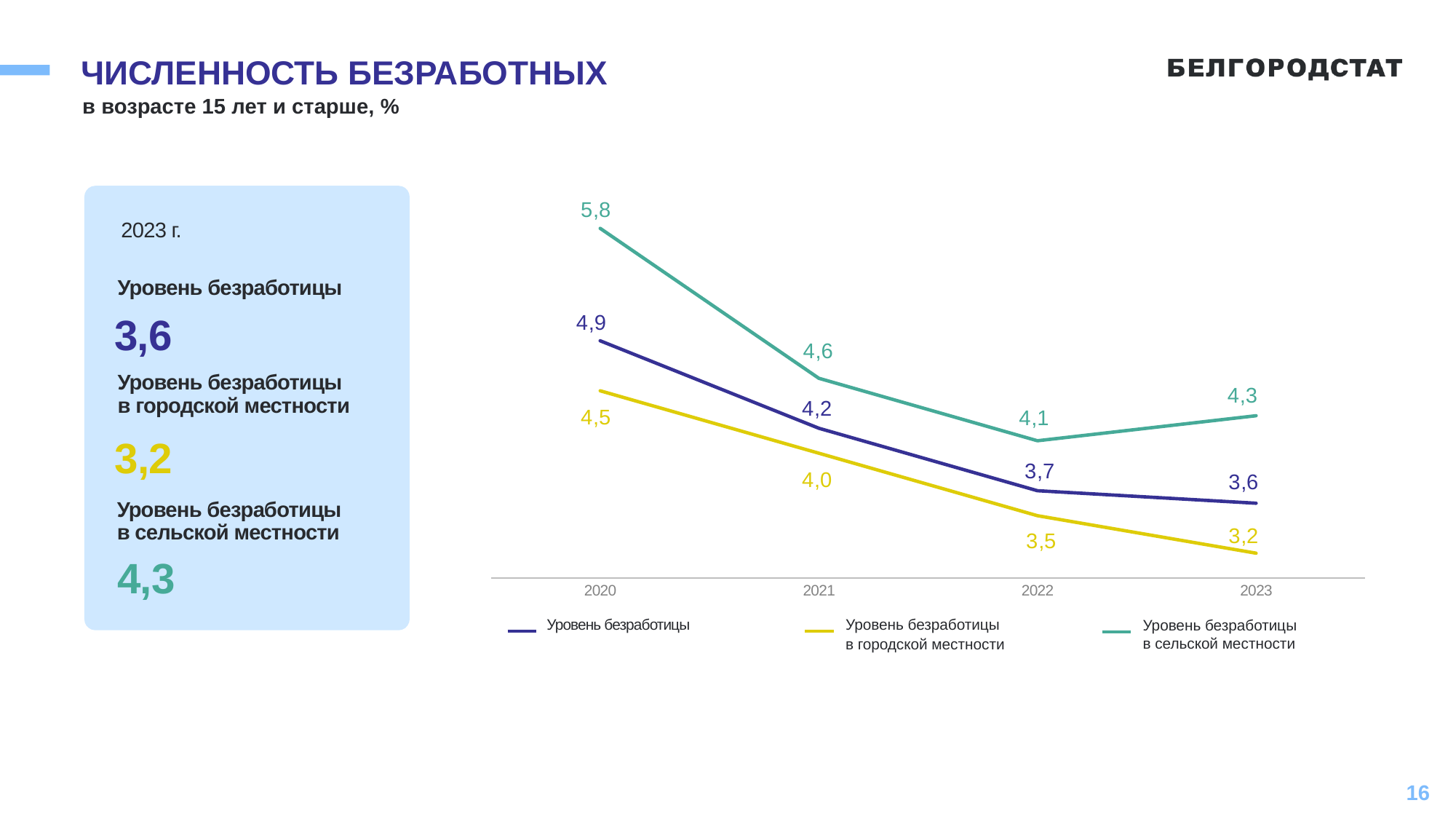
How many years are plotted along the x axis? 4 What is the value of 'Уровень безработицы' in 2020? 4,9 In which year is 'Уровень безработицы в городской местности' lowest? 2023 Which colour is used for the 'Уровень безработицы в городской местности' line? yellow In which year is 'Уровень безработицы в сельской местности' highest? 2020 What type of chart is shown on the slide? line chart How many series does the legend list? 3 What is the difference between 'Уровень безработицы в сельской местности' and 'Уровень безработицы в городской местности' in 2020? 1,3 What is the value of 'Уровень безработицы в городской местности' in 2023? 3,2 What is the value of 'Уровень безработицы в сельской местности' in 2022? 4,1 Does 'Уровень безработицы в городской местности' rise or fall from 2020 to 2023? fall Which is larger in 2021: 'Уровень безработицы' or 'Уровень безработицы в городской местности'? Уровень безработицы